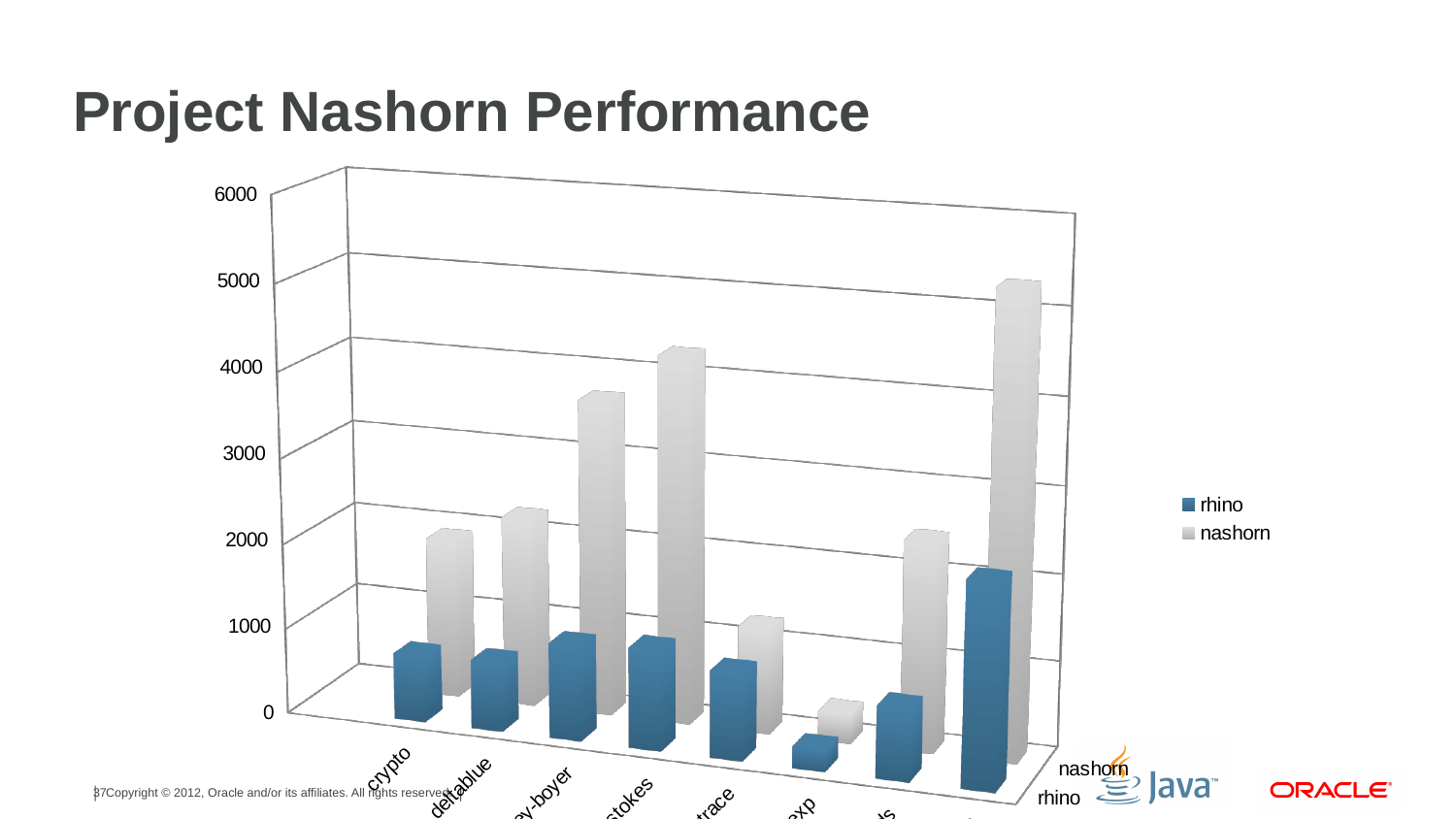
Is the nashorn value for deltablue greater or less than 1000? greater For crypto, which series has the larger value, rhino or nashorn? nashorn How many series does the legend list? 2 For deltablue, which series has the larger value, rhino or nashorn? nashorn What is the highest value shown on the vertical axis? 6000 What kind of chart is shown on the slide? bar chart Is the rhino value for deltablue greater or less than 3000? less Is the rhino value for crypto greater or less than 2000? less How many categories (benchmarks) are plotted on the x axis? 8 What are the two series named in the legend? rhino and nashorn What is the title of the slide containing the chart? Project Nashorn Performance